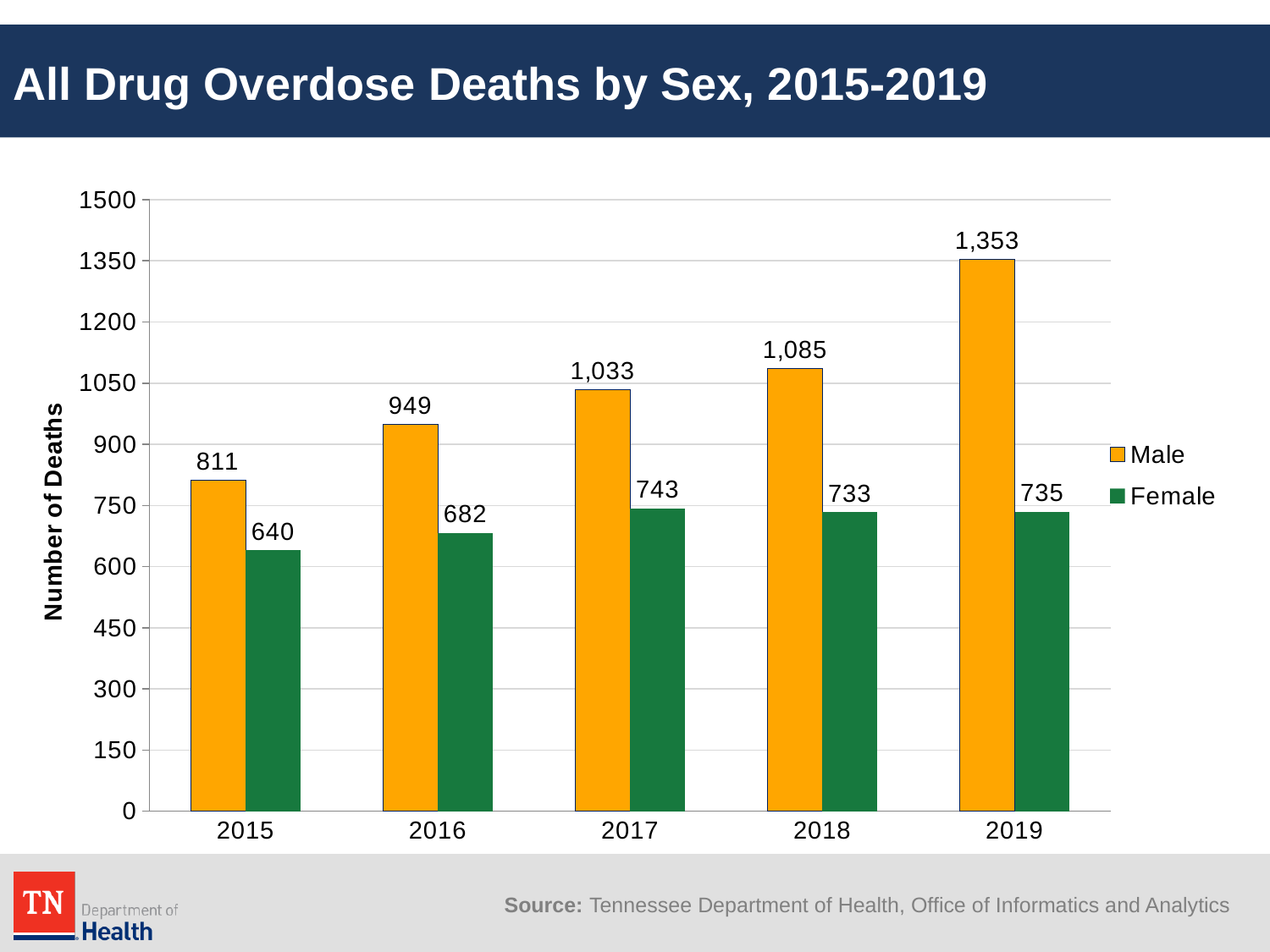
Do male deaths rise or fall from 2015 to 2019? Rise Which year has the highest number of male deaths? 2019 Which year has the lowest number of female deaths? 2015 Is the value for male deaths in 2018 greater or less than 1050? greater How many series does the legend list? 2 What is the label of the y axis? Number of Deaths How many years are shown on the x axis? 5 What is the number of male drug overdose deaths in 2019? 1,353 What is the difference between male and female deaths in 2019? 618 What is the number of female drug overdose deaths in 2016? 682 What kind of chart is shown on the slide? Bar chart Which is larger, female deaths in 2017 or female deaths in 2018? Female deaths in 2017